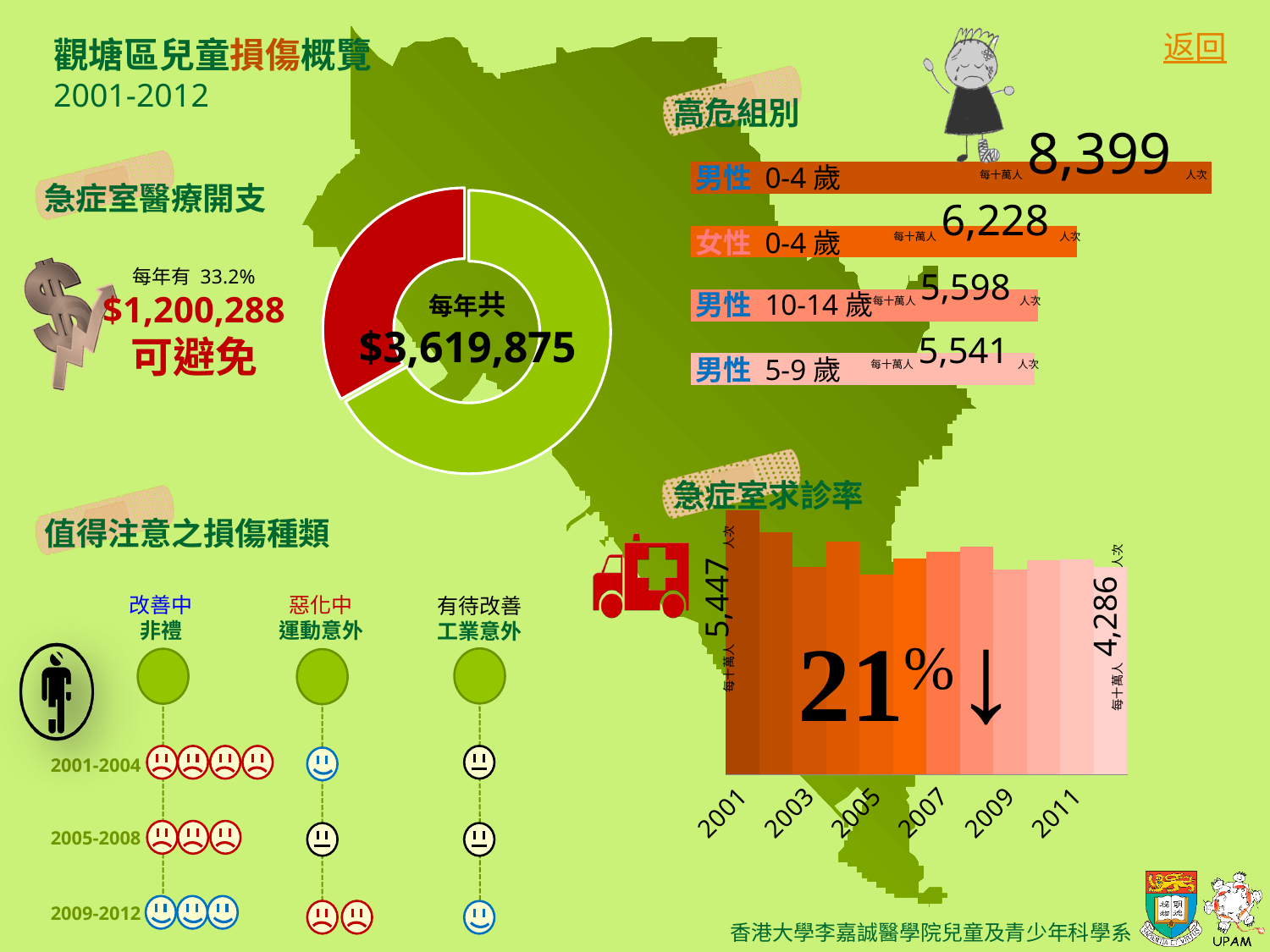
In the 急症室求診率 chart, what is the value for the last year shown? 4,286 In the 急症室求診率 chart, do the values overall rise or fall from 2001 to 2012? fall In the 高危組別 chart, what is the value for 男性 0-4 歲? 8,399 In the 高危組別 chart, what is the value for 男性 5-9 歲? 5,541 In the 高危組別 chart, which group has the highest value? 男性 0-4 歲 In the 急症室醫療開支 donut chart, what is the total annual amount (每年共)? $3,619,875 In the 急症室求診率 chart, what is the value for 2001? 5,447 What kind of chart is the 高危組別 chart? bar chart In the 高危組別 chart, how many groups are shown? 4 In the 高危組別 chart, what is the value for 女性 0-4 歲? 6,228 In the 高危組別 chart, what is the difference between 男性 0-4 歲 and 女性 0-4 歲? 2,171 In the 高危組別 chart, which group has the lowest value? 男性 5-9 歲